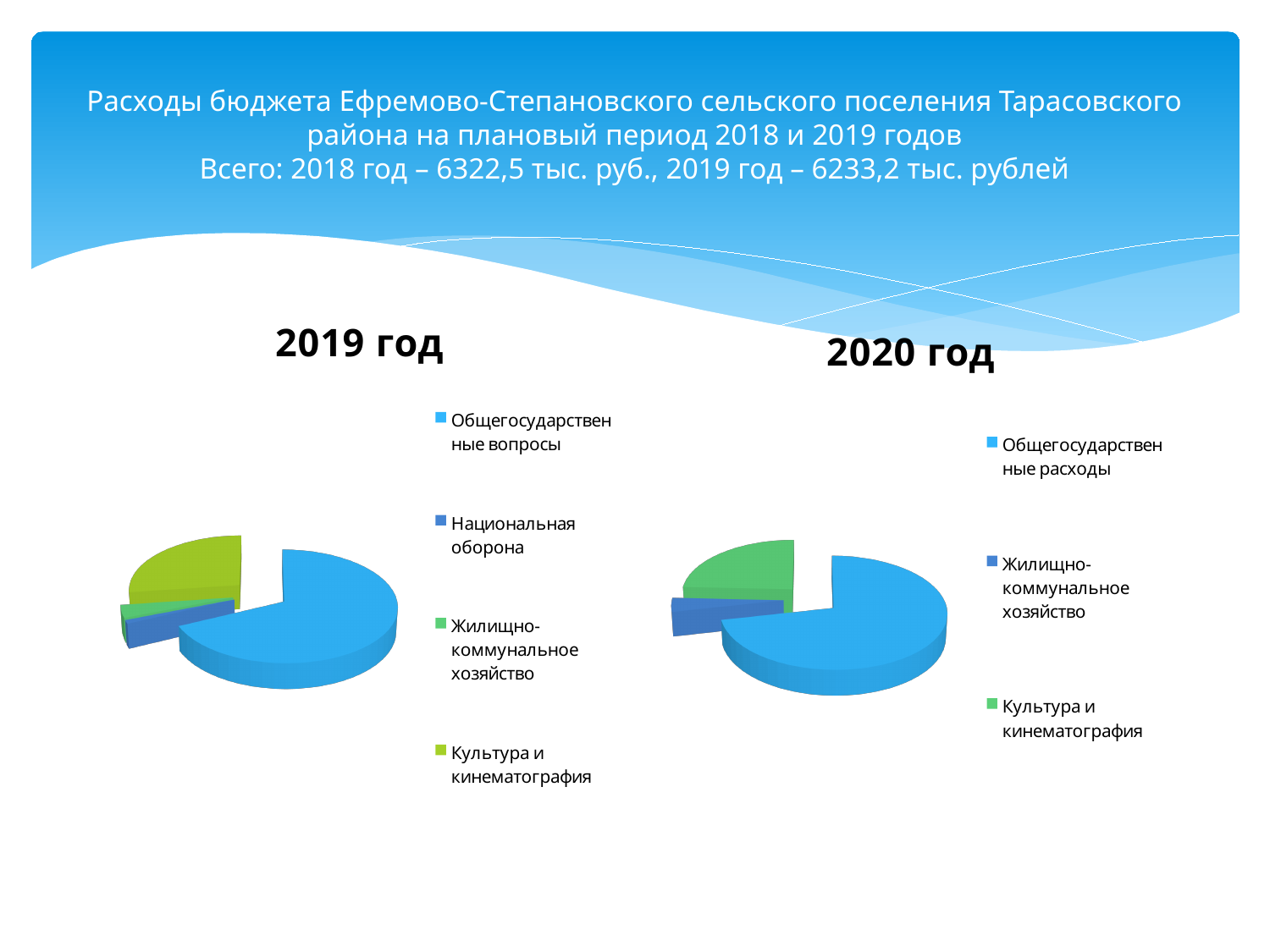
In the "2020 год" chart, which slice is larger: Культура и кинематография or Жилищно-коммунальное хозяйство? Культура и кинематография In the "2019 год" chart, which category has the largest slice? Общегосударственные вопросы What are the titles of the two pie charts on the slide? 2019 год and 2020 год In the "2020 год" chart, which category has the largest slice? Общегосударственные расходы In the "2019 год" chart, which slice is larger: Общегосударственные вопросы or Национальная оборона? Общегосударственные вопросы In the "2020 год" chart, how many categories does the legend list? 3 What kind of chart is the "2019 год" chart? pie chart In the "2020 год" chart, which category has the smallest slice? Жилищно-коммунальное хозяйство In the "2019 год" chart, how many categories does the legend list? 4 In the "2019 год" chart, which slice is larger: Общегосударственные вопросы or Культура и кинематография? Общегосударственные вопросы Which legend entry appears in the "2019 год" chart but not in the "2020 год" chart? Национальная оборона What kind of chart is the "2020 год" chart? pie chart